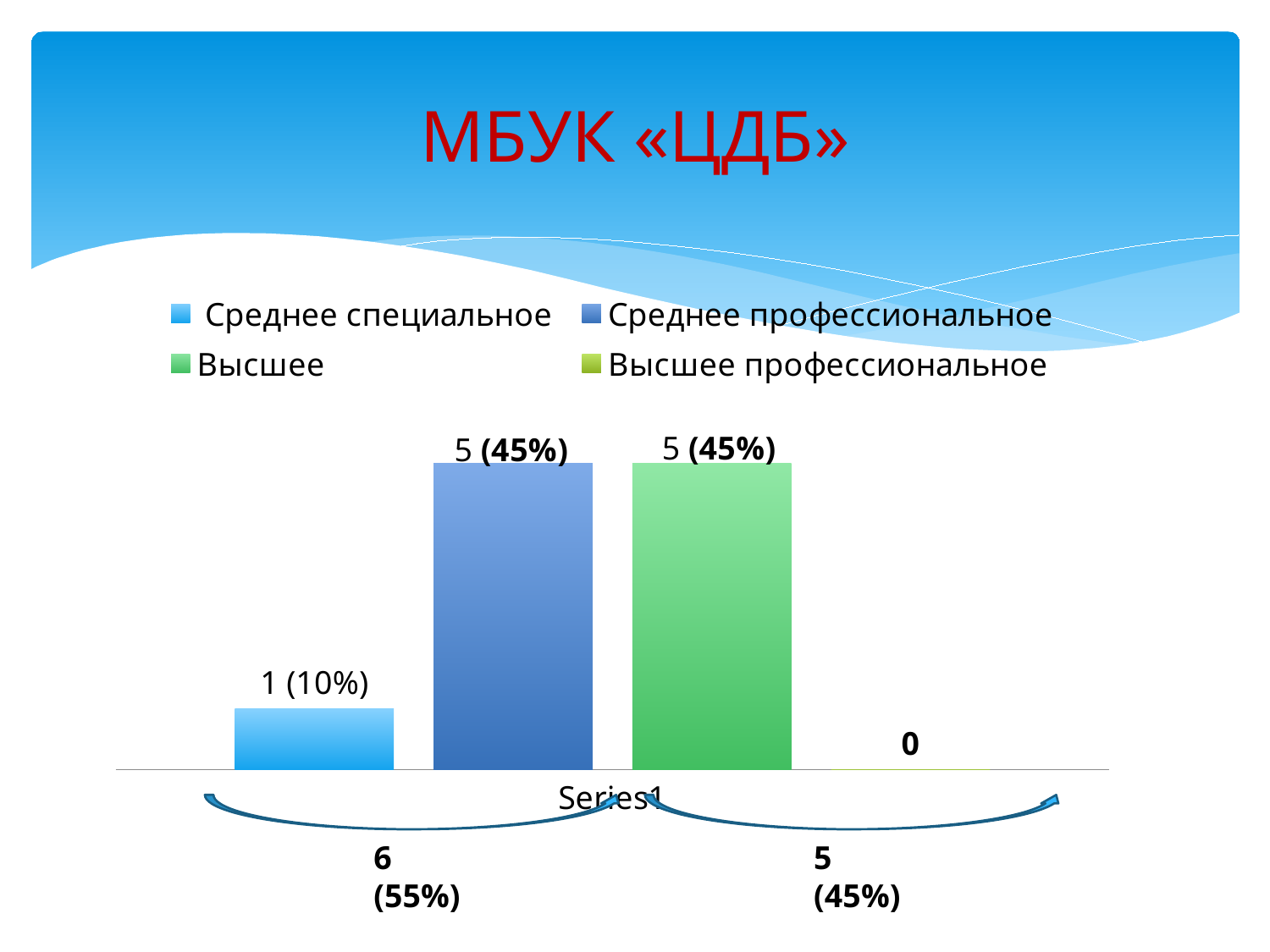
What is the combined value shown under the bracket for the first two bars? 6 (55%) Which is larger, the value for Высшее or the value for Среднее специальное? Высшее What value is shown for Высшее? 5 (45%) What is the title of the slide? МБУК «ЦДБ» What value is shown for Высшее профессиональное? 0 What value is shown for Среднее специальное? 1 (10%) What value is shown for Среднее профессиональное? 5 (45%) What kind of chart is shown on the slide? bar chart Which series has the lowest value? Высшее профессиональное How many series does the legend list? 4 What is the category label shown on the x axis? Series1 What is the difference between the values for Среднее профессиональное and Среднее специальное? 4